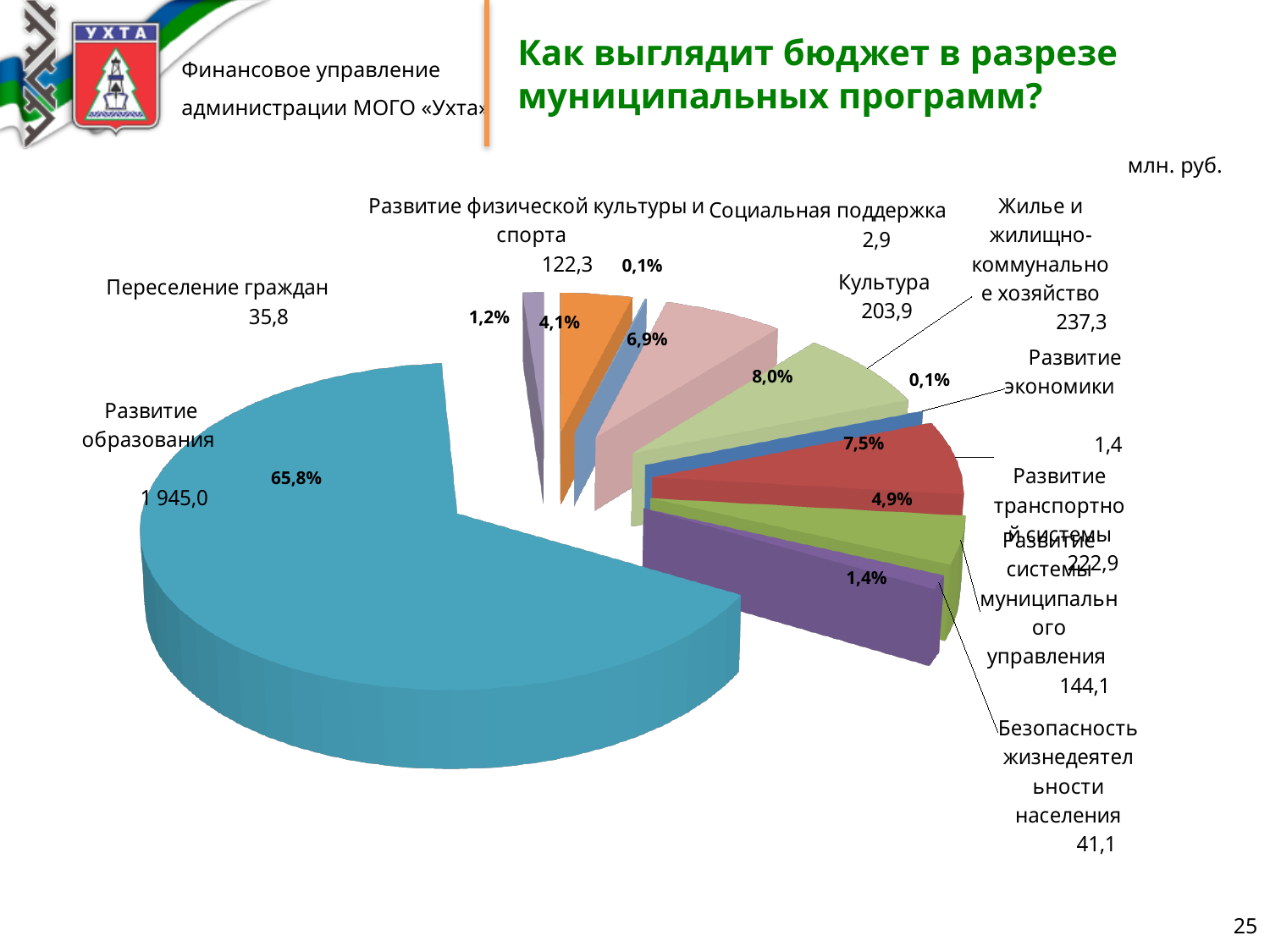
What is the value for Жилье и жилищно-коммунальное хозяйство? 237,3 Which category has the smallest value? Развитие экономики Which category has the largest value? Развитие образования What share of the pie does Развитие образования represent? 65,8% What is the value for Культура? 203,9 What is the value for Безопасность жизнедеятельности населения? 41,1 What kind of chart is shown on the slide? pie chart What is the difference between Жилье и жилищно-коммунальное хозяйство and Развитие транспортной системы? 14,4 In what units are the values on the chart given? млн. руб. What is the value for Развитие образования? 1 945,0 How many categories does the pie chart show? 10 Which is larger, Развитие физической культуры и спорта or Развитие системы муниципального управления? Развитие системы муниципального управления